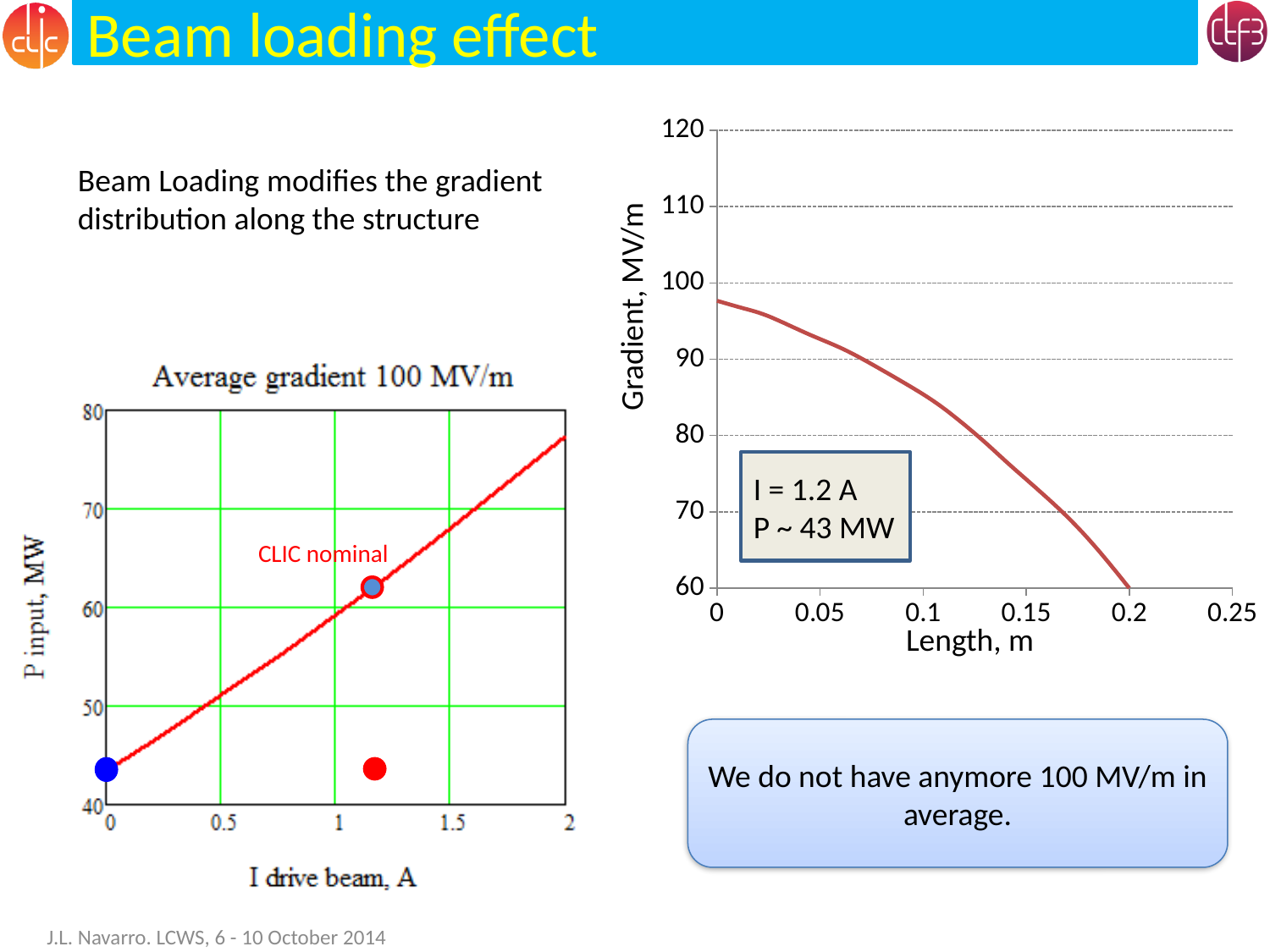
What is the title of the chart on the left? Average gradient 100 MV/m In the chart titled 'Average gradient 100 MV/m', is the P input at I drive beam = 2 A greater or less than 70? greater What is the y-axis label of the chart on the right? Gradient, MV/m What is the x-axis label of the chart titled 'Average gradient 100 MV/m'? I drive beam, A In the chart on the right, is the gradient at a length of 0.15 m greater or less than 70? greater In the chart titled 'Average gradient 100 MV/m', is the P input at I drive beam = 0 A greater or less than 50? less In the chart on the right, does the gradient rise or fall as length increases? fall What kind of chart is the chart on the right (Gradient vs Length)? line chart In the chart titled 'Average gradient 100 MV/m', does P input rise or fall as I drive beam increases? rise